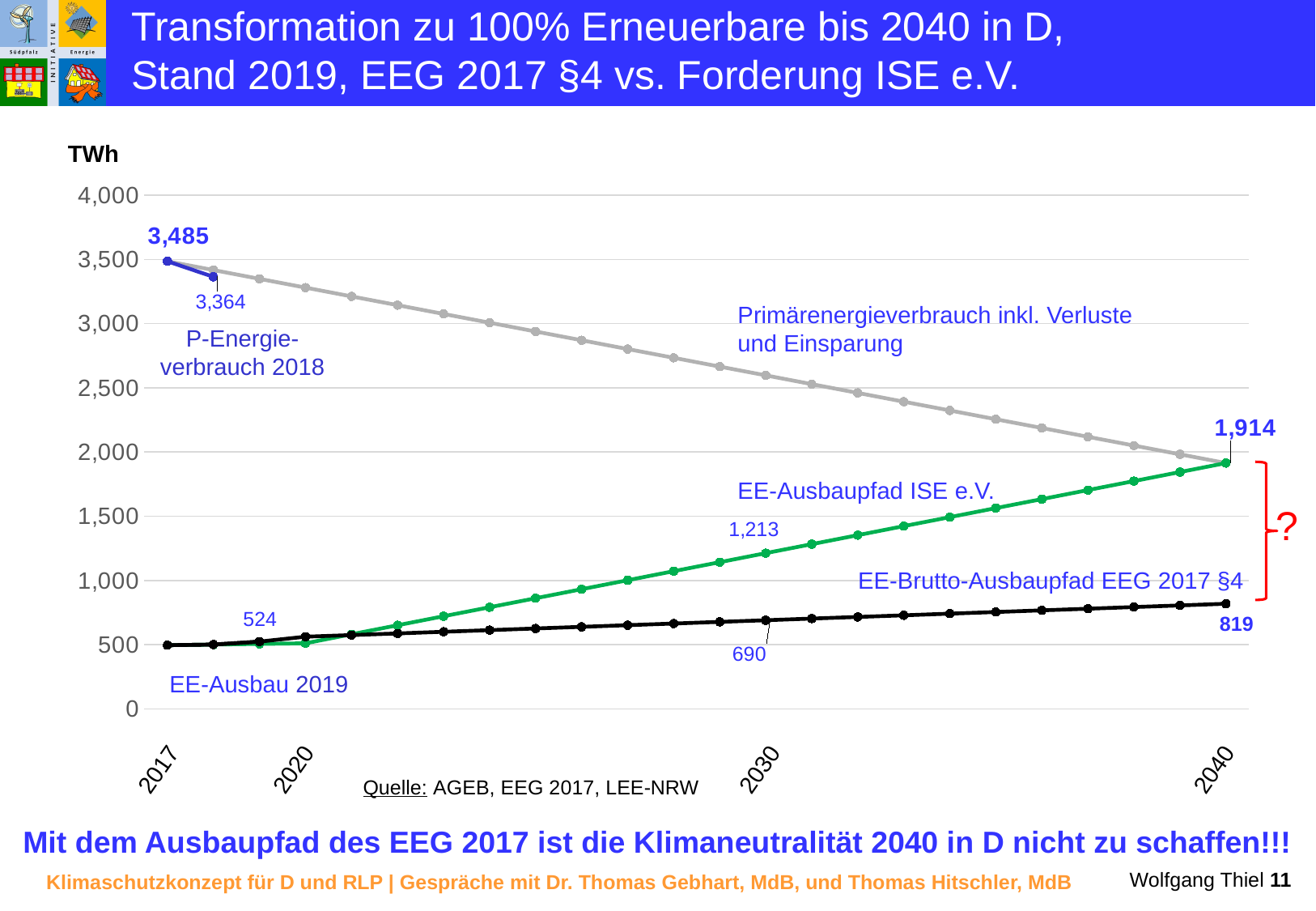
What value does the EE-Ausbaupfad ISE e.V. series reach in 2040? 1,914 What value is labelled for P-Energieverbrauch 2018? 3,364 In 2030, which series has the larger value: EE-Ausbaupfad ISE e.V. or EE-Brutto-Ausbaupfad EEG 2017 §4? EE-Ausbaupfad ISE e.V. What is the difference between the EE-Ausbaupfad ISE e.V. value and the EE-Brutto-Ausbaupfad EEG 2017 §4 value in 2040? 1,095 What is the difference between the labelled 2030 values of the EE-Ausbaupfad ISE e.V. and the EE-Brutto-Ausbaupfad EEG 2017 §4? 523 What value is labelled for the EE-Ausbaupfad ISE e.V. series in 2030? 1,213 Does the Primärenergieverbrauch series rise or fall from 2017 to 2040? fall What value is labelled for the EE-Brutto-Ausbaupfad EEG 2017 §4 series in 2030? 690 What is the value of the Primärenergieverbrauch series in 2017? 3,485 What unit is shown on the y axis of the chart? TWh What value does the EE-Brutto-Ausbaupfad EEG 2017 §4 series reach in 2040? 819 What kind of chart is shown on the slide? line chart